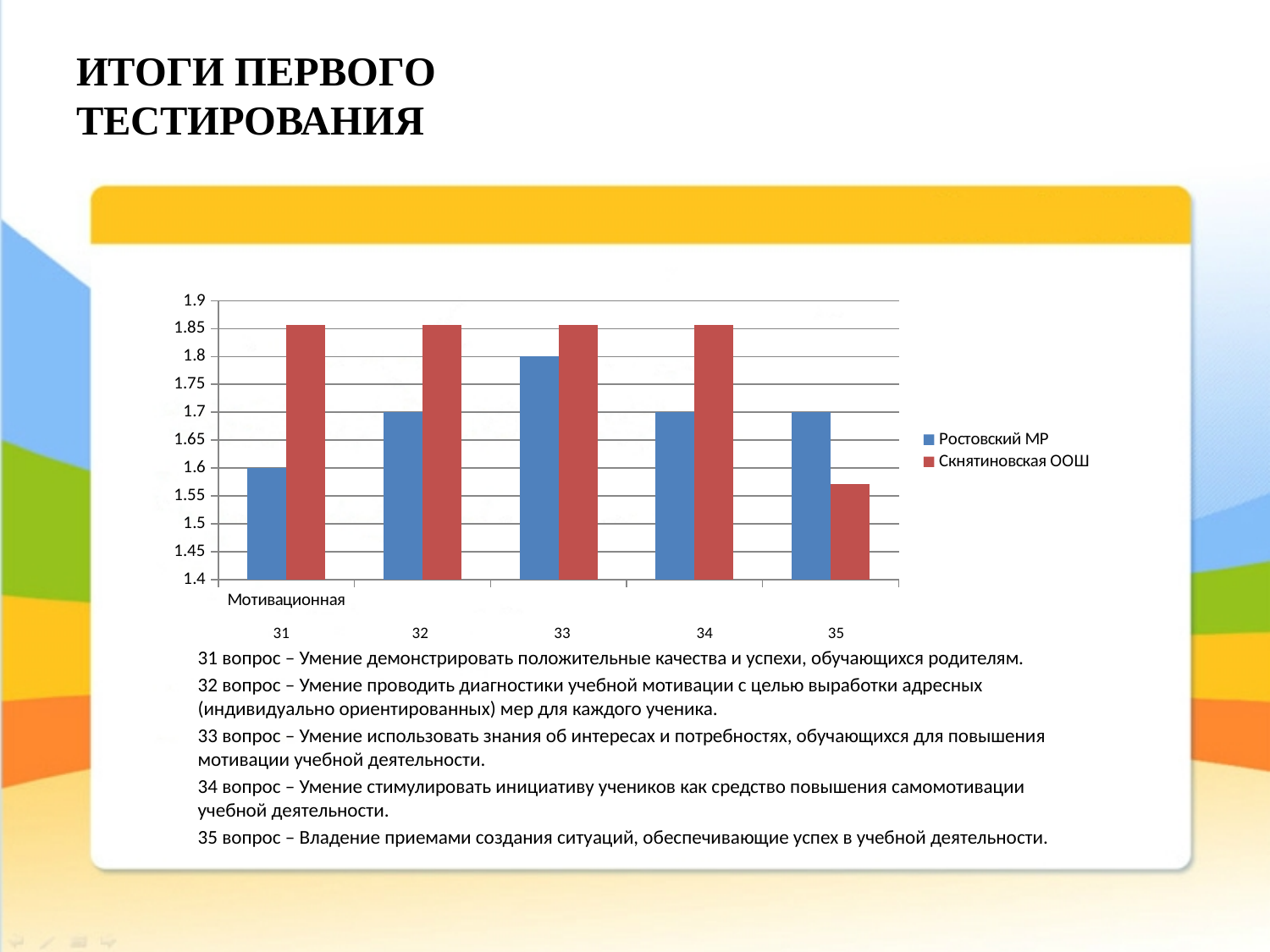
Is the value for Скнятиновская ООШ for question 35 greater or less than 1.6? less How many question categories are plotted along the x axis? 5 What is the difference between the Ростовский МР values for questions 33 and 31? 0.2 What is the value for Ростовский МР for question 32? 1.7 For question 35, which series has the larger value, Ростовский МР or Скнятиновская ООШ? Ростовский МР Is the value for Скнятиновская ООШ for question 31 greater or less than 1.8? greater How many series does the legend list? 2 What kind of chart is shown on the slide? bar chart For which question is the Ростовский МР value lowest? 31 What is the value for Ростовский МР for question 33? 1.8 What is the value for Ростовский МР for question 31? 1.6 For which question is the Ростовский МР value highest? 33